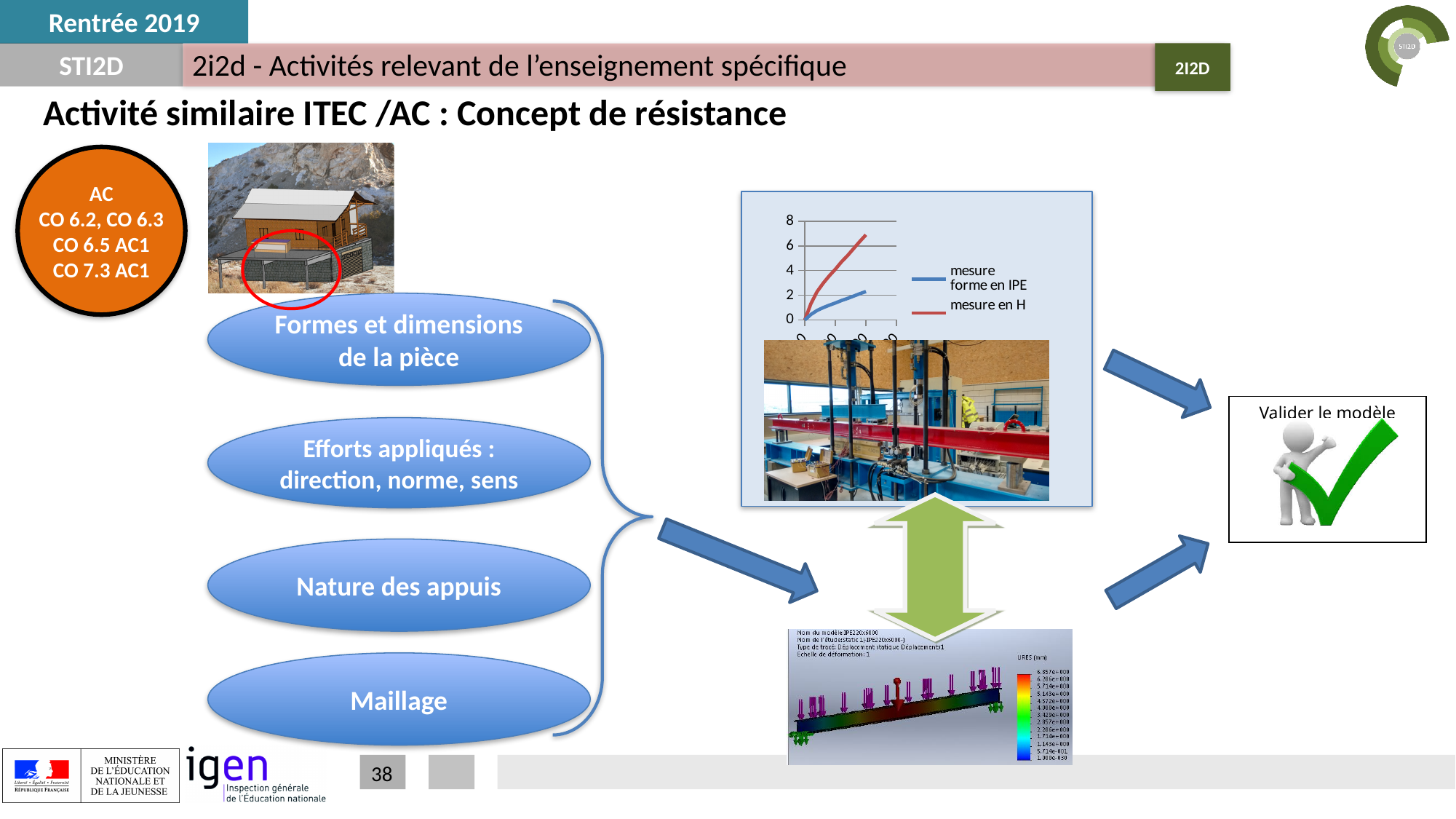
What is the highest value shown on the chart's y axis? 8 What are the two series named in the chart's legend? mesure forme en IPE; mesure en H What kind of chart is shown on the slide? line chart Which series reaches the higher value at the right end of the chart, 'mesure forme en IPE' or 'mesure en H'? mesure en H Which colour is used for the 'mesure en H' series in the chart? red Is the final value of the 'mesure en H' series greater or less than 6? greater Is the final value of the 'mesure forme en IPE' series greater or less than 4? less Do the values of the 'mesure en H' series rise or fall along the x axis? rise Do the values of the 'mesure forme en IPE' series rise or fall along the x axis? rise How many series does the chart's legend list? 2